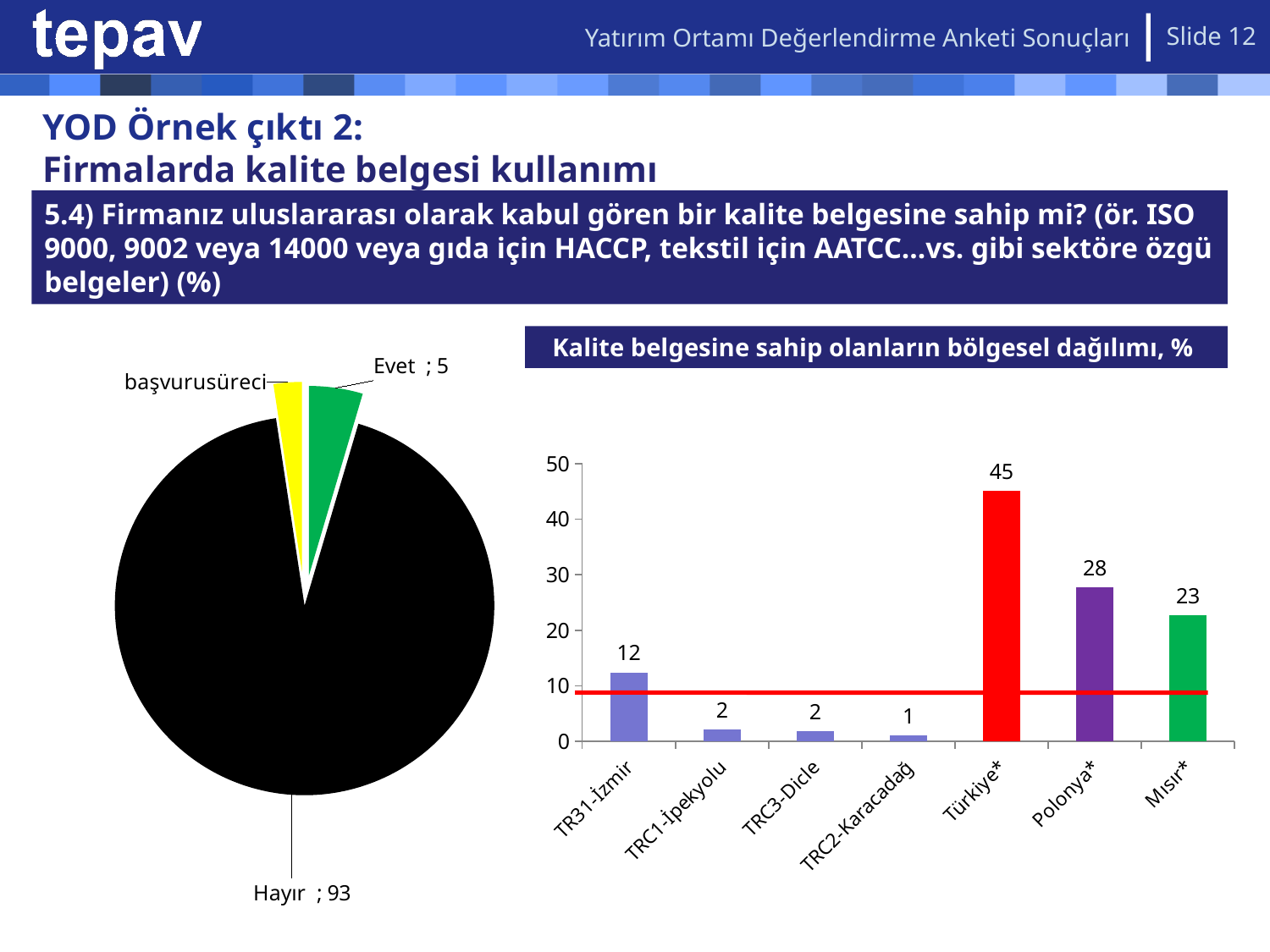
In the pie chart on the left, what is the value for Evet? 5 In the bar chart 'Kalite belgesine sahip olanların bölgesel dağılımı, %', what is the value for Türkiye*? 45 What kind of chart is the chart on the left of the slide? Pie chart In the bar chart 'Kalite belgesine sahip olanların bölgesel dağılımı, %', which category has the highest value? Türkiye* How many categories are shown in the bar chart 'Kalite belgesine sahip olanların bölgesel dağılımı, %'? 7 In the bar chart 'Kalite belgesine sahip olanların bölgesel dağılımı, %', which is larger, Polonya* or TR31-İzmir? Polonya* In the bar chart 'Kalite belgesine sahip olanların bölgesel dağılımı, %', which category has the lowest value? TRC2-Karacadağ In the pie chart on the left, which slice is the largest? Hayır In the pie chart on the left, what is the value for Hayır? 93 What kind of chart is the chart on the right of the slide? Bar chart In the bar chart 'Kalite belgesine sahip olanların bölgesel dağılımı, %', what is the value for TR31-İzmir? 12 In the bar chart 'Kalite belgesine sahip olanların bölgesel dağılımı, %', what is the difference between Polonya* and Mısır*? 5